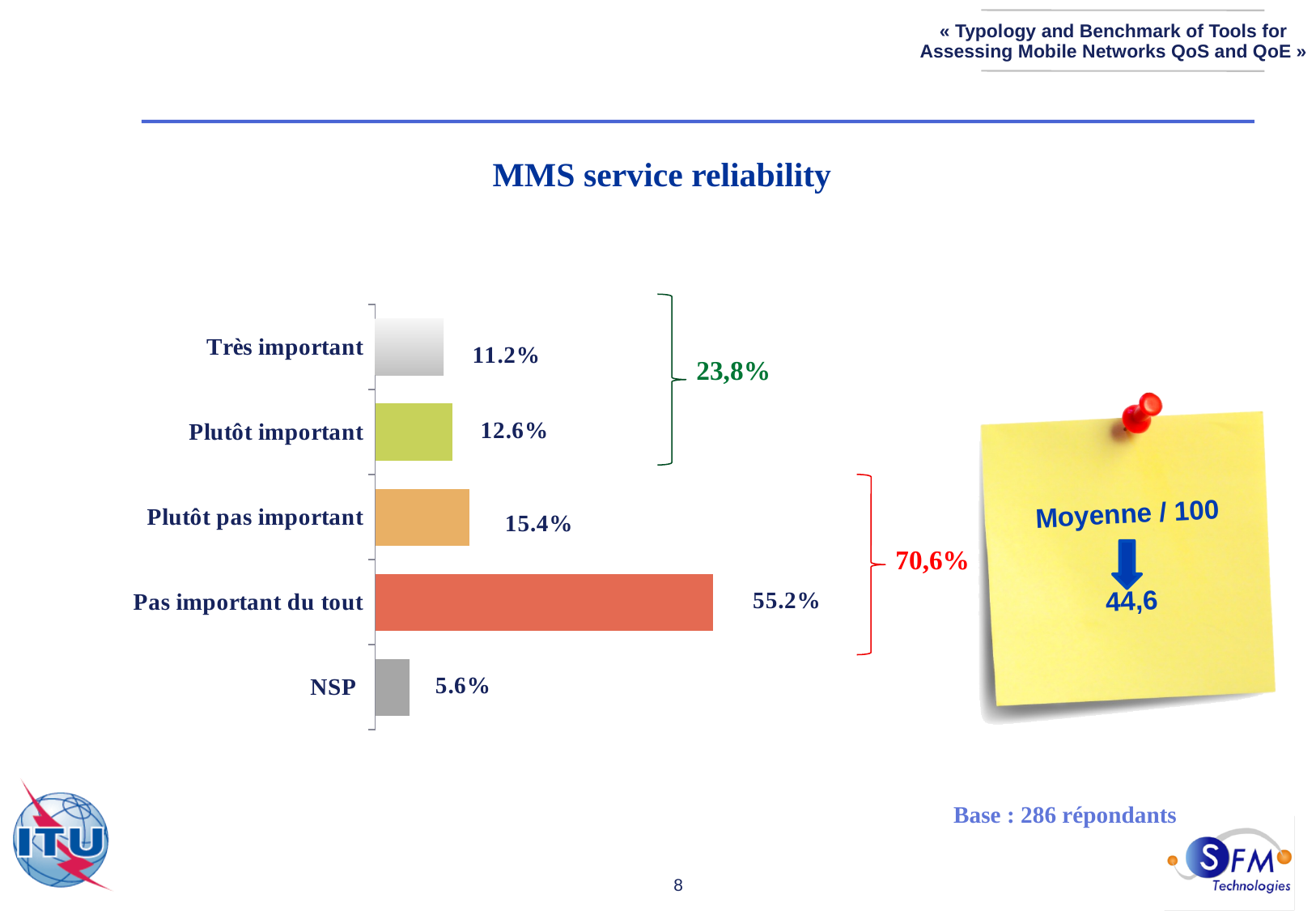
What is the title of the chart? MMS service reliability How many categories are shown in the chart? 5 What is the combined value shown by the green bracket for "Très important" and "Plutôt important"? 23,8% Which is larger, "Plutôt important" or "Très important"? Plutôt important What is the value for "Très important"? 11.2% What is the combined value shown by the red bracket for "Plutôt pas important" and "Pas important du tout"? 70,6% What kind of chart is shown on the slide? Bar chart What is the difference between "Plutôt pas important" and "Plutôt important"? 2.8% Which category has the highest value? Pas important du tout What is the value for "Pas important du tout"? 55.2% What is the value for "NSP"? 5.6% Which category has the lowest value? NSP